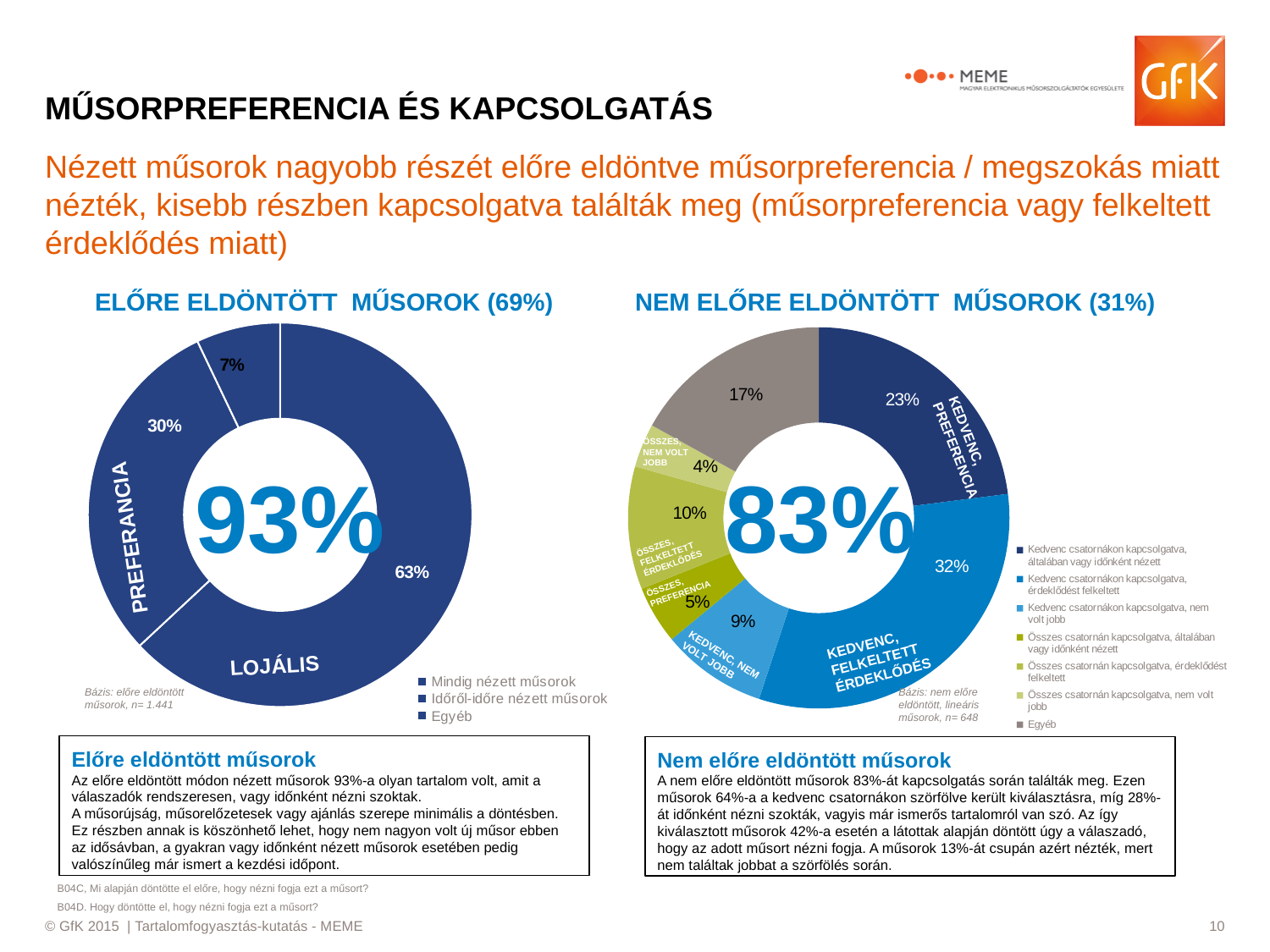
In the 'NEM ELŐRE ELDÖNTÖTT MŰSOROK (31%)' chart, which is larger: the 'KEDVENC, NEM VOLT JOBB' slice or the 'ÖSSZES, FELKELTETT ÉRDEKLŐDÉS' slice? ÖSSZES, FELKELTETT ÉRDEKLŐDÉS (10%) In the 'NEM ELŐRE ELDÖNTÖTT MŰSOROK (31%)' chart, what is the value of the 'Egyéb' slice? 17% What kind of chart is used for 'ELŐRE ELDÖNTÖTT MŰSOROK (69%)'? Doughnut (pie) chart In the 'NEM ELŐRE ELDÖNTÖTT MŰSOROK (31%)' chart, what is the value of the slice labelled 'KEDVENC, FELKELTETT ÉRDEKLŐDÉS'? 32% In the 'NEM ELŐRE ELDÖNTÖTT MŰSOROK (31%)' chart, what is the smallest slice's value? 4% In the 'NEM ELŐRE ELDÖNTÖTT MŰSOROK (31%)' chart, how many slices are there? 7 In the 'ELŐRE ELDÖNTÖTT MŰSOROK (69%)' chart, what is the difference between the 63% slice and the 30% slice? 33 percentage points In the 'NEM ELŐRE ELDÖNTÖTT MŰSOROK (31%)' chart, what is the value of the slice labelled 'KEDVENC, PREFERENCIA'? 23% In the 'ELŐRE ELDÖNTÖTT MŰSOROK (69%)' chart, what is the smallest slice's value? 7% How many entries does the legend of the 'ELŐRE ELDÖNTÖTT MŰSOROK (69%)' chart list? 3 What large number is printed in the centre of the 'ELŐRE ELDÖNTÖTT MŰSOROK (69%)' chart? 93% In the 'ELŐRE ELDÖNTÖTT MŰSOROK (69%)' chart, what is the largest slice's value? 63%